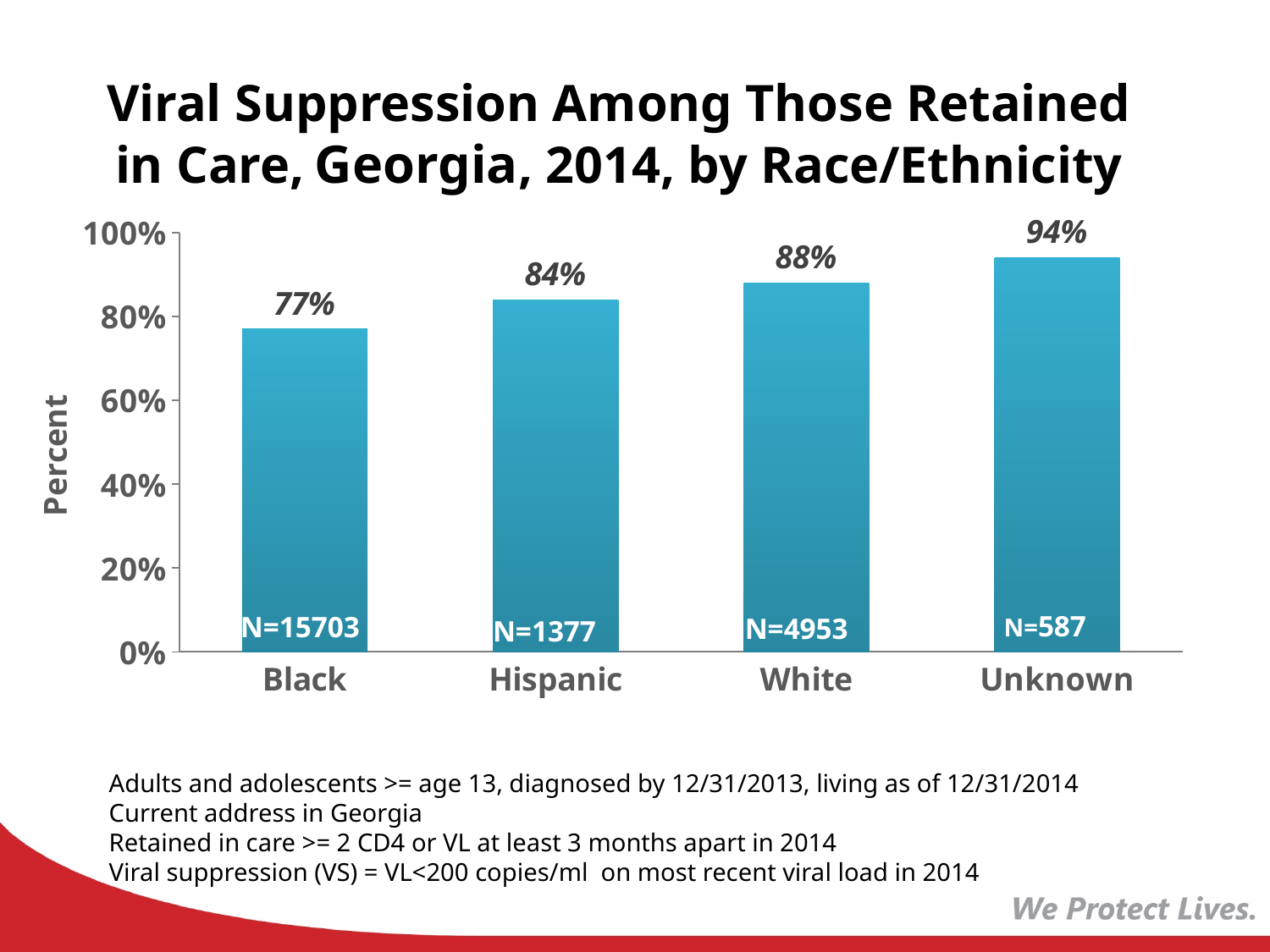
Which race/ethnicity category has the lowest viral suppression percentage? Black Which has a higher viral suppression percentage, Hispanic or White? White How many race/ethnicity categories are shown on the chart? 4 What is the difference in viral suppression percentage between Unknown and Black? 17% Which race/ethnicity category has the highest viral suppression percentage? Unknown What is the label on the vertical axis? Percent Is the value for Black greater or less than 80%? less What kind of chart is shown on the slide? Bar chart What is the viral suppression percentage for Hispanic? 84% What is the viral suppression percentage for Black? 77% What is the viral suppression percentage for White? 88% What is the N value shown for the Unknown category? N=587